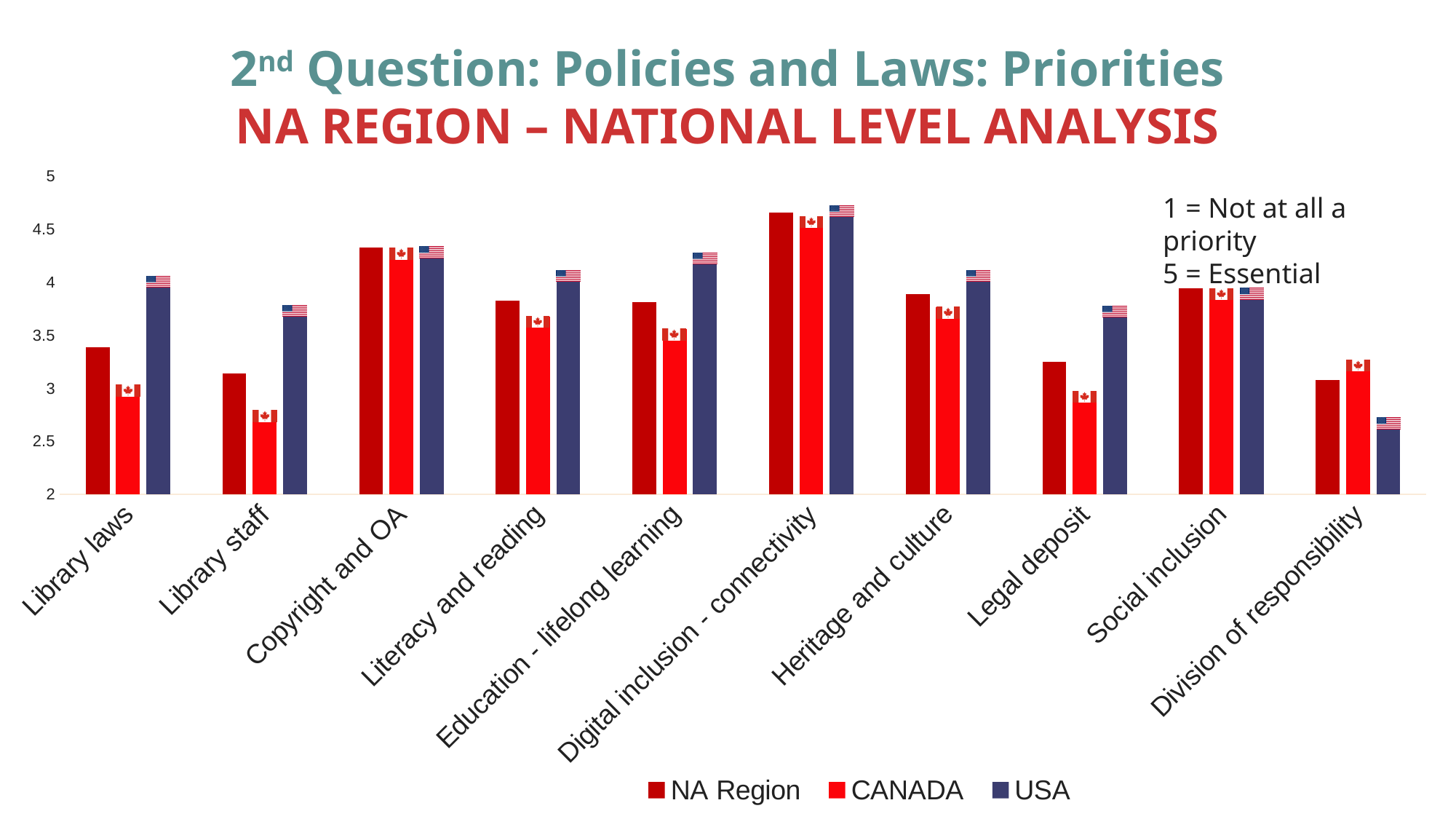
For which category is the CANADA value lowest? Library staff How many series does the legend list? 3 What type of chart is shown on the slide? Bar chart For which category is the USA value lowest? Division of responsibility For Division of responsibility, which is larger: the CANADA value or the USA value? CANADA How many categories are shown along the x axis? 10 For which category is the USA value highest? Digital inclusion - connectivity According to the note on the slide, what does a score of 5 mean? Essential Is the CANADA value for Library staff greater or less than 3? less For which category is the NA Region value highest? Digital inclusion - connectivity Is the USA value for Legal deposit greater or less than 3.5? greater Is the NA Region value for Digital inclusion - connectivity greater or less than 4.5? greater